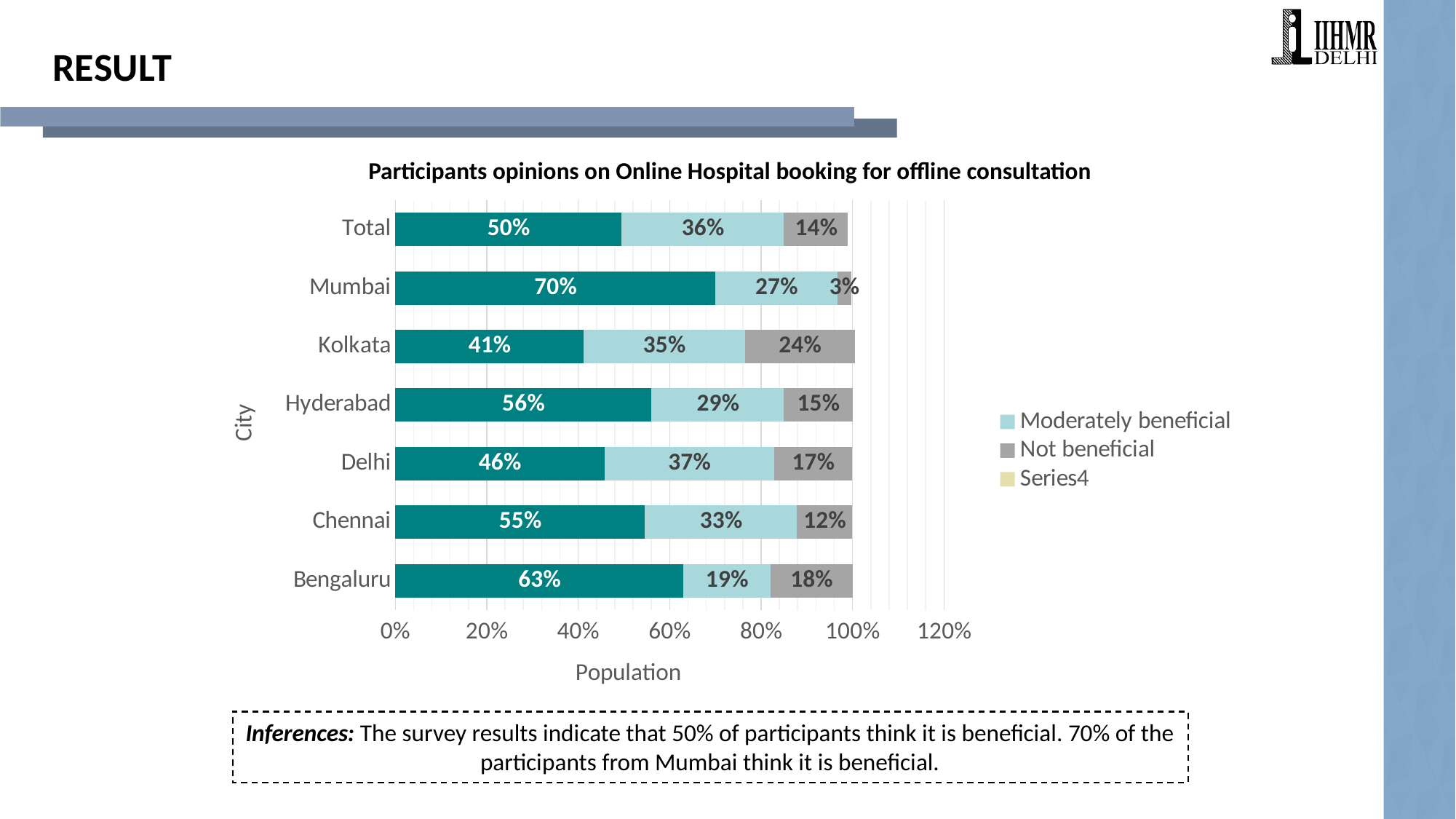
How many categories are shown on the y axis of the chart? 7 What is the Moderately beneficial value for Mumbai? 27% What is the total of the three labelled segments in the Kolkata bar? 100% What value is printed on the dark teal segment of the Hyderabad bar? 56% What is the Moderately beneficial value for Delhi? 37% How much larger is the Moderately beneficial value for Total than for Bengaluru? 17 percentage points What kind of chart is shown on the slide? Stacked bar chart What is the Not beneficial value for Kolkata? 24% Which city has the lowest Not beneficial value? Mumbai Which city has the highest Not beneficial value? Kolkata How many entries does the legend list? 3 Which has the larger Not beneficial value, Delhi or Hyderabad? Delhi